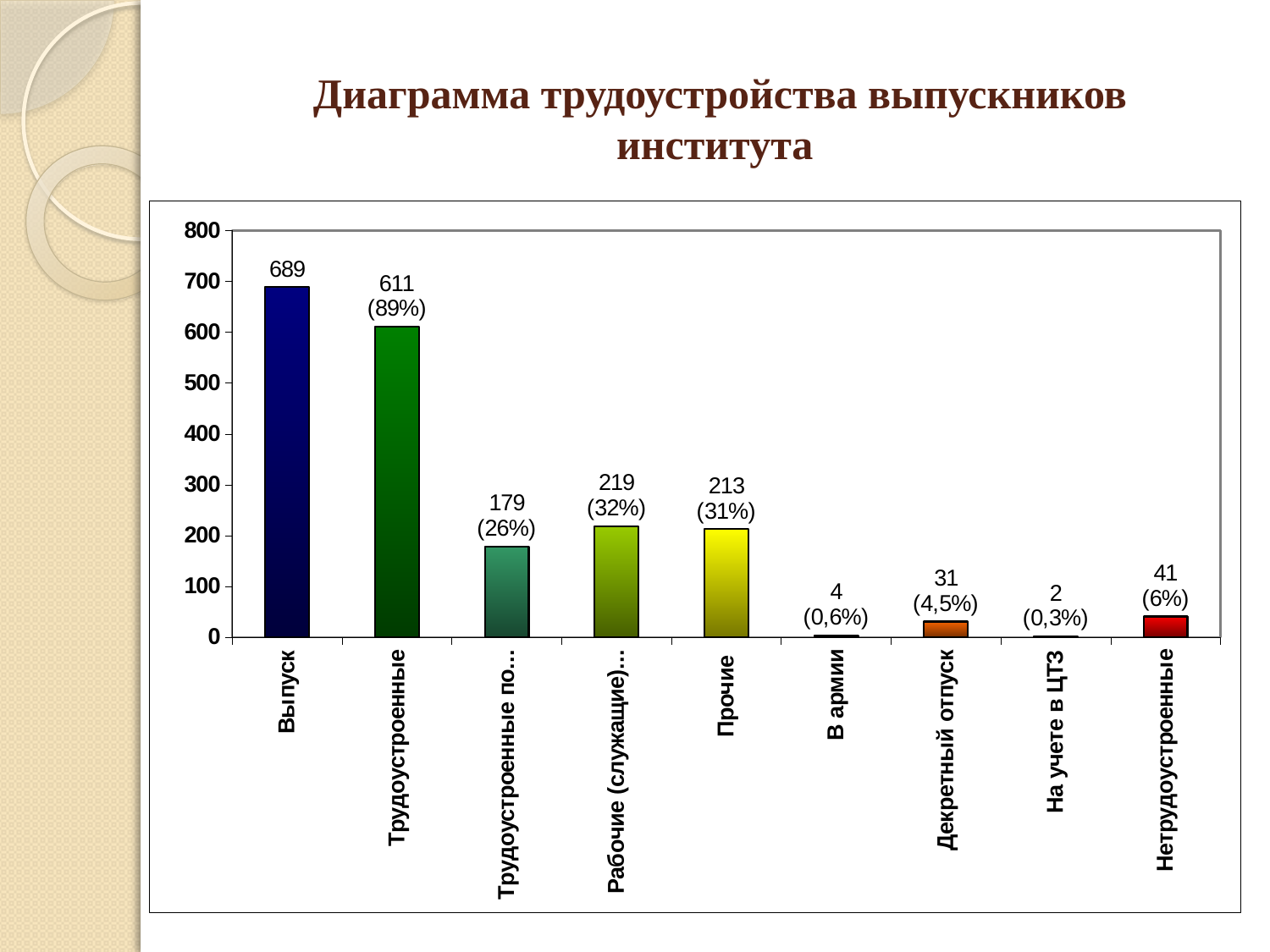
How many categories are shown on the x axis? 9 What is the difference between the values for Выпуск and Трудоустроенные? 78 What percentage is shown for В армии? 0,6% What kind of chart is shown on the slide? bar chart Which category has the lowest value? На учете в ЦТЗ What percentage is shown for Трудоустроенные? 89% What is the value for Выпуск? 689 Which is larger, the value for Декретный отпуск or the value for Нетрудоустроенные? Нетрудоустроенные What is the value for Трудоустроенные? 611 Which category has the highest value? Выпуск What is the value for Декретный отпуск? 31 What is the value for Нетрудоустроенные? 41